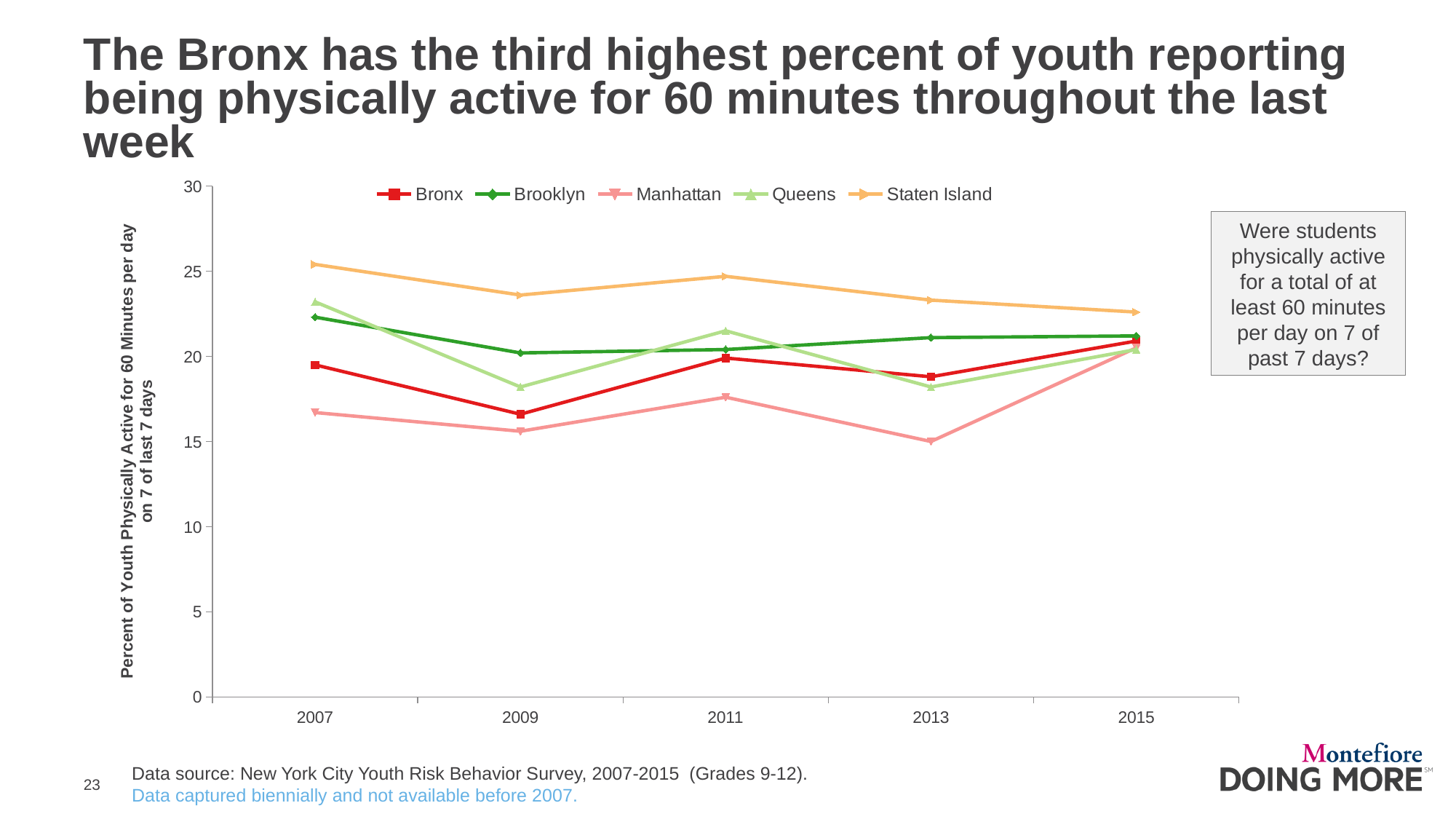
Which borough had the lowest percent of physically active youth in 2009? Manhattan Which borough had the highest percent of physically active youth in 2007? Staten Island Does the Staten Island line generally rise or fall from 2007 to 2015? fall Is the value for the Bronx in 2009 greater or less than 20? less In 2009, which was higher: Queens or Manhattan? Queens How many years are plotted along the x axis? 5 Is the value for Brooklyn in 2015 greater or less than 20? greater In 2011, which was higher: Staten Island or the Bronx? Staten Island What kind of chart is shown on the slide? line chart How many series does the legend list? 5 Which borough had the lowest percent of physically active youth in 2013? Manhattan Is the value for Manhattan in 2013 greater or less than 20? less